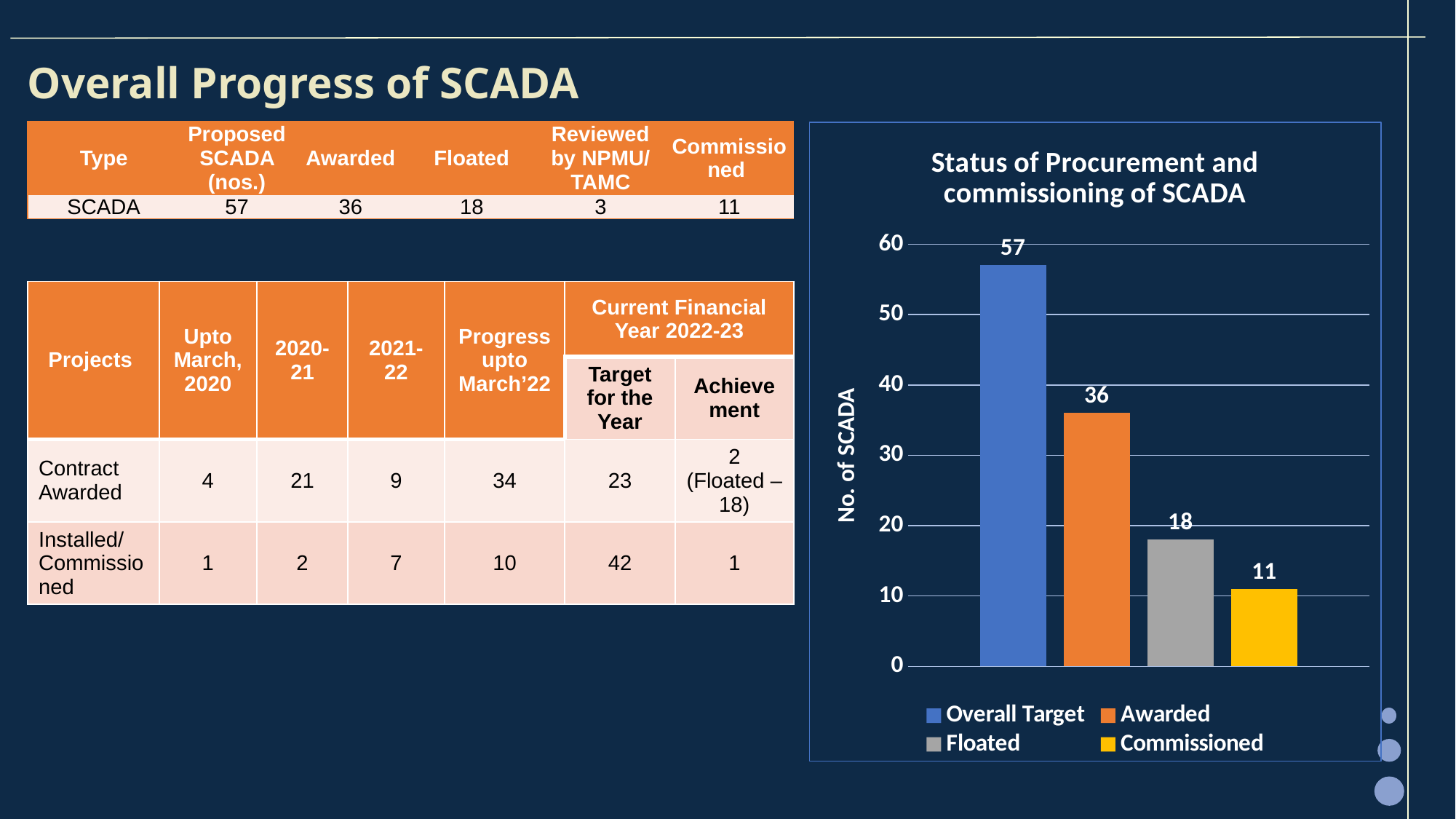
What is the value for Commissioned in the chart? 11 Which is larger, Awarded or Floated? Awarded What is the value for Awarded in the chart? 36 How many series does the legend list? 4 What is the value for Floated in the chart? 18 Which series has the highest value in the chart? Overall Target What is the title of the chart? Status of Procurement and commissioning of SCADA Which series has the lowest value in the chart? Commissioned What is the value for Overall Target in the chart? 57 What kind of chart is shown on the slide? Bar chart What is the difference between the Overall Target and Awarded values? 21 What is the difference between the Floated and Commissioned values? 7